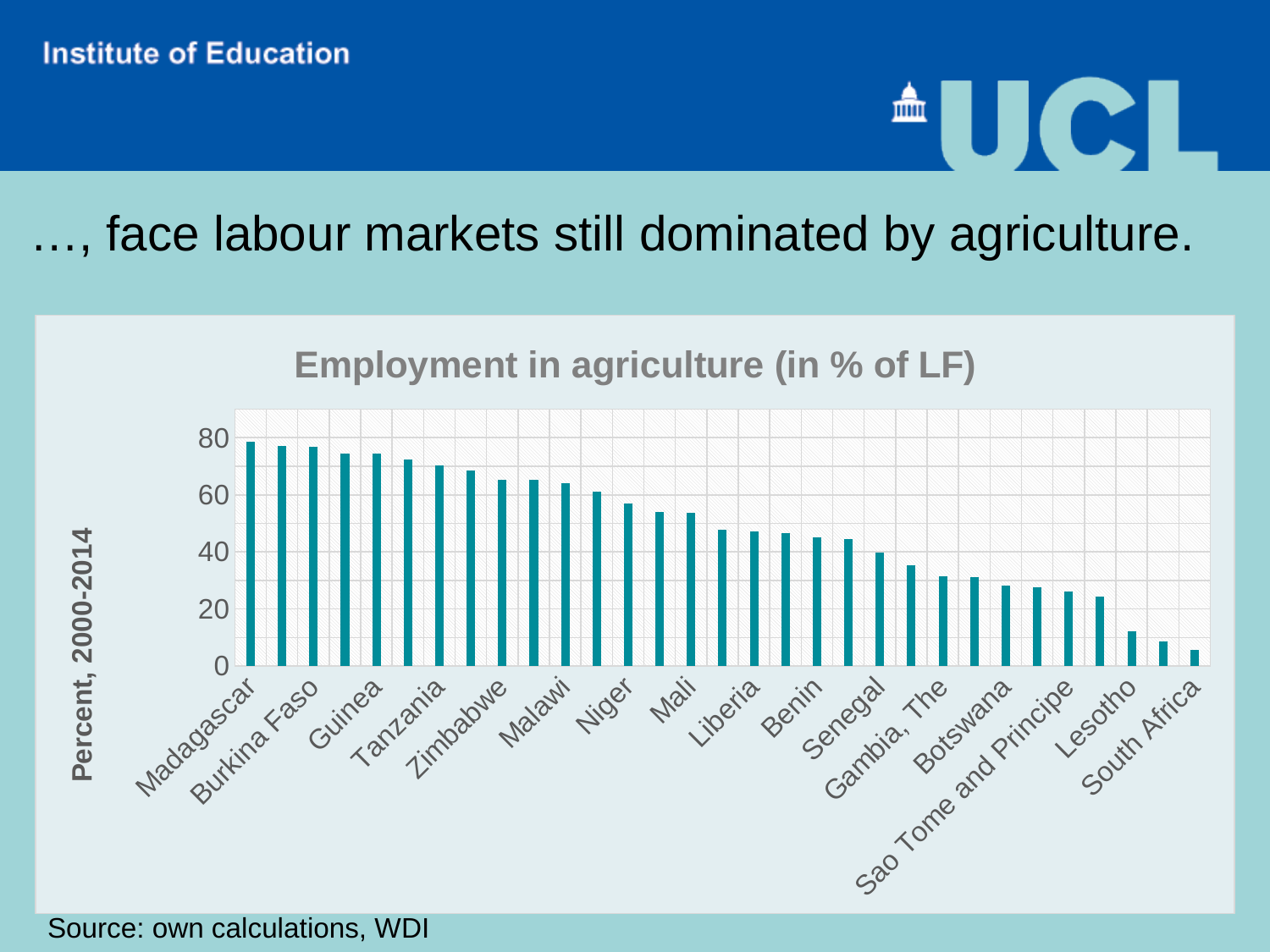
Is the value for South Africa greater or less than 20? less Is the value for Lesotho greater or less than 20? less What kind of chart is shown on the slide? bar chart Is the value for Gambia, The greater or less than 40? less Which labelled country has the lowest employment in agriculture? South Africa What is the label on the vertical axis of the chart? Percent, 2000-2014 Which has the larger value, Guinea or Botswana? Guinea Which labelled country has the highest employment in agriculture? Madagascar What is the title of the chart? Employment in agriculture (in % of LF) Do the values rise or fall moving from left to right along the x axis? fall